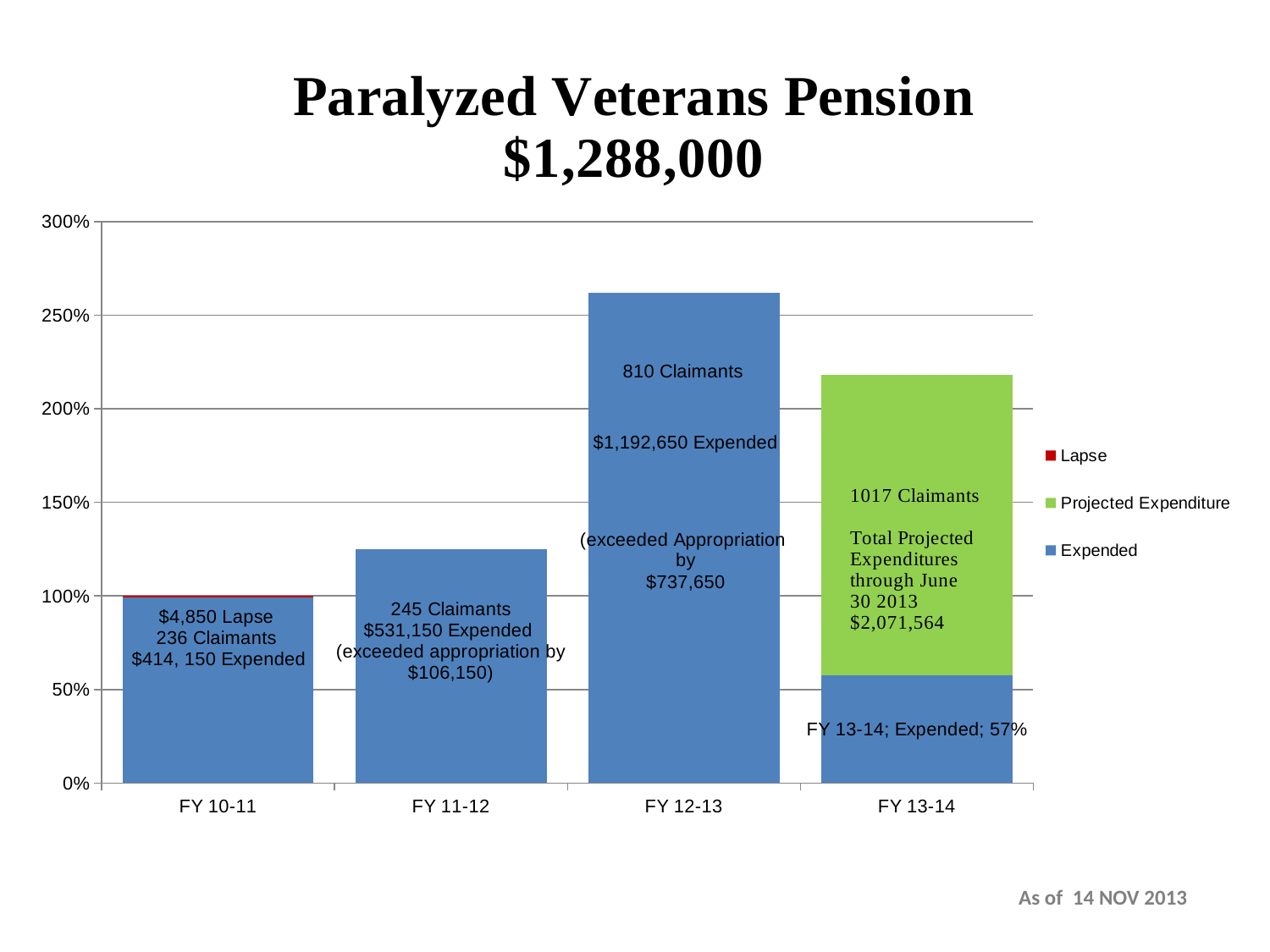
How many series does the legend list? 3 Is the Expended value for FY 11-12 greater or less than 100%? greater Which fiscal year has the shortest bar? FY 10-11 What is the title of the chart? Paralyzed Veterans Pension $1,288,000 How many claimants are labelled for FY 12-13? 810 Claimants Is the Expended value for FY 12-13 greater or less than 250%? greater What colour represents Projected Expenditure in the legend? green Which bar is taller, FY 11-12 or FY 12-13? FY 12-13 What kind of chart is shown on the slide? bar chart What is the Expended value for FY 13-14? 57% Which fiscal year has the tallest bar? FY 12-13 How many fiscal year categories are shown on the x axis? 4